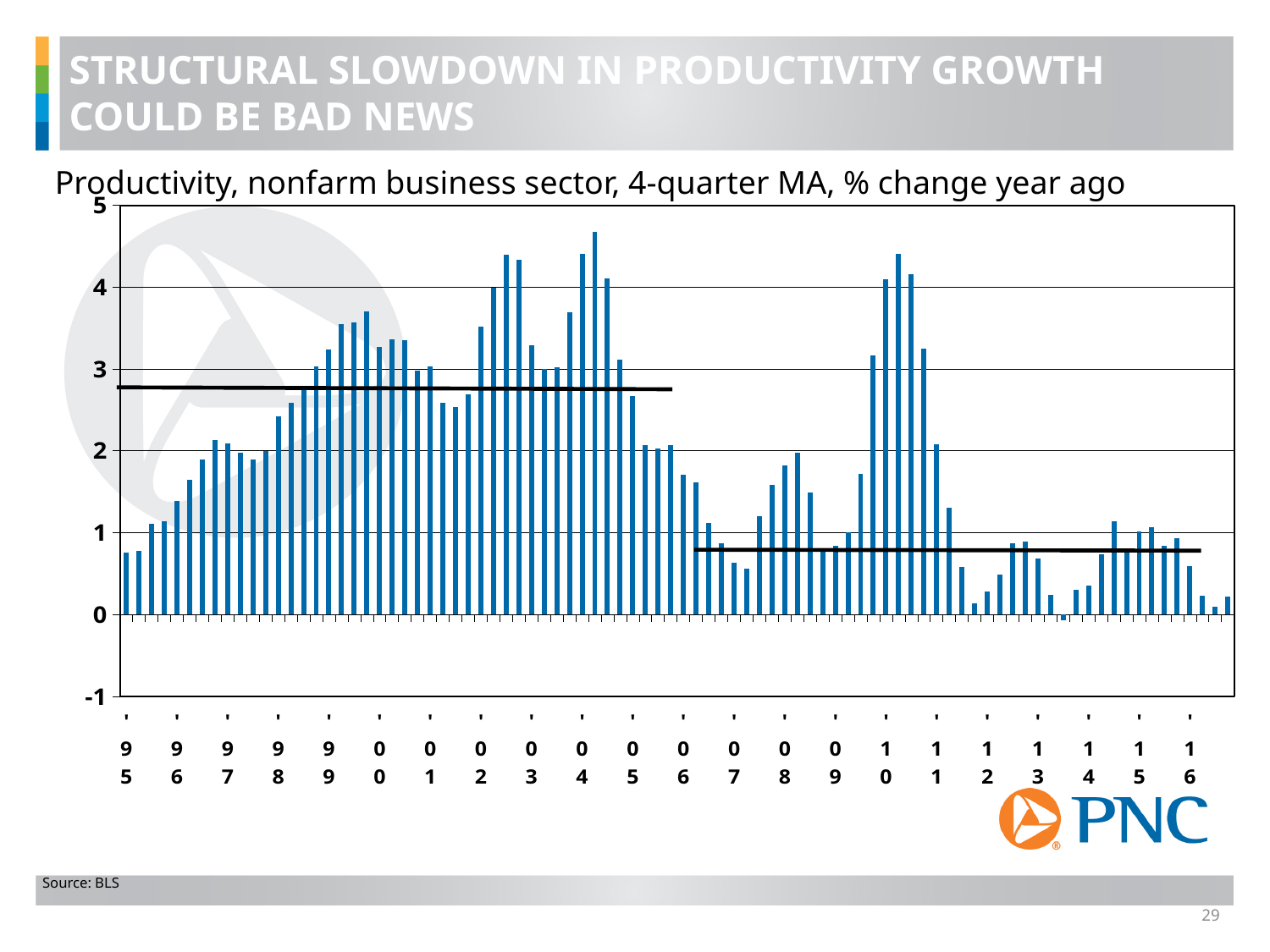
Are the values in 2016 greater or less than 1? less Do the values generally rise or fall from 2010 to 2016? fall Is the peak value around 2010 greater or less than 4? greater What kind of chart is shown on the slide? bar chart Which period has the higher values: around 2004 or around 2013? around 2004 Do the values generally rise or fall from 1995 to 2004? rise Is the value for the first bar in 1995 greater or less than 1? less What is the title of the chart? Productivity, nonfarm business sector, 4-quarter MA, % change year ago How many year labels appear along the x axis of the chart? 22 What source is cited for the chart data? BLS